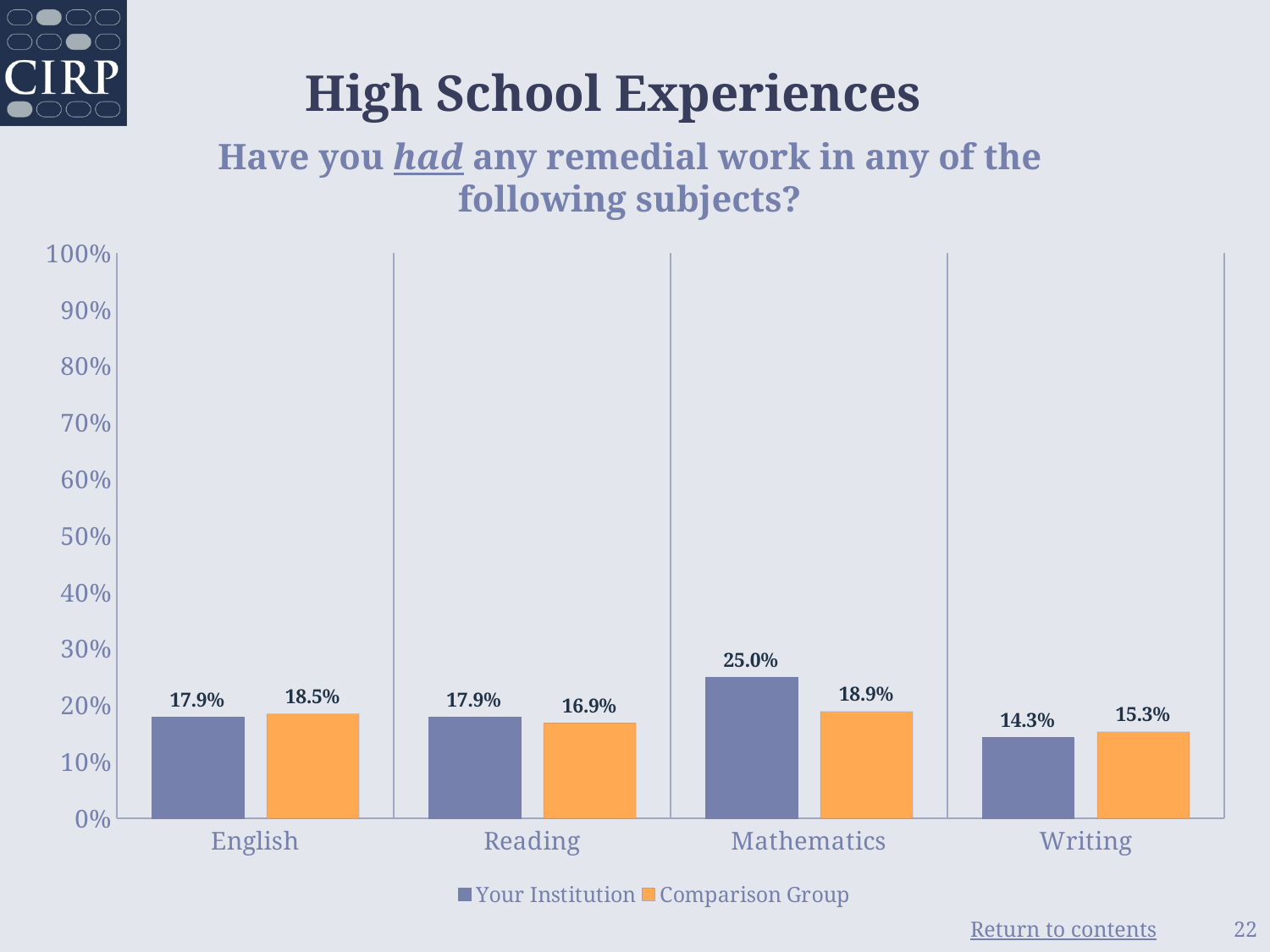
How many subjects are shown on the x axis? 4 Which subject has the highest value for Your Institution? Mathematics What is the value for Your Institution in English? 17.9% What is the value for Your Institution in Mathematics? 25.0% What is the value for Comparison Group in Writing? 15.3% Is the value for Your Institution in Mathematics greater or less than 20%? greater How many series does the legend list? 2 What is the difference between Your Institution and Comparison Group in Mathematics? 6.1% What is the value for Comparison Group in Reading? 16.9% What kind of chart is shown on the slide? Bar chart Which subject has the lowest value for Comparison Group? Writing Which is larger in Writing: Your Institution or Comparison Group? Comparison Group